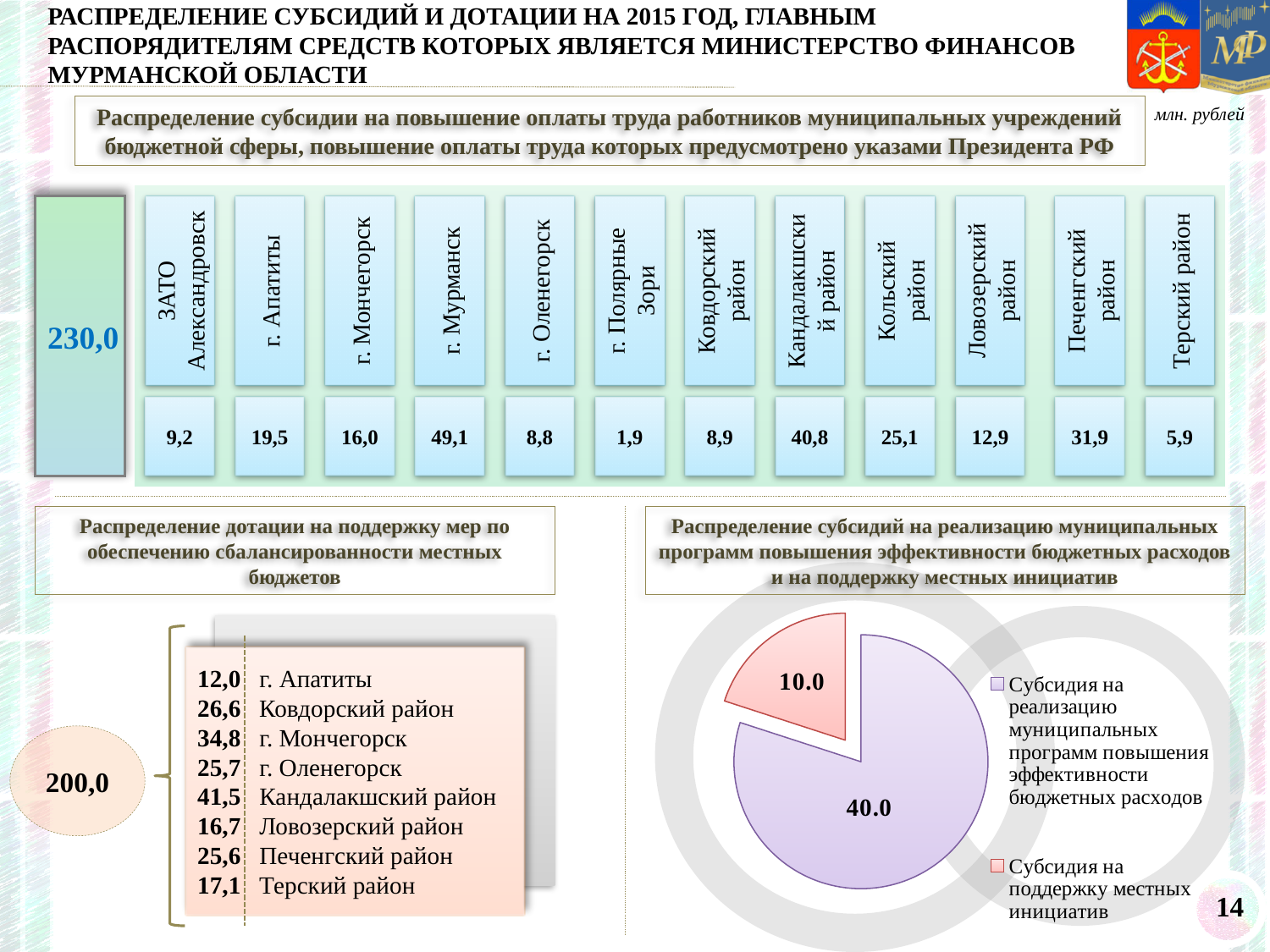
In the pie chart at the bottom right, what is the difference between the two slice values? 30.0 How many entries does the legend of the pie chart at the bottom right list? 2 In the pie chart at the bottom right, what share of the whole pie does the "Субсидия на поддержку местных инициатив" slice represent? 20% In the pie chart at the bottom right, what colour is the slice for "Субсидия на поддержку местных инициатив"? Red (pink) In the pie chart at the bottom right, which slice is the largest? Субсидия на реализацию муниципальных программ повышения эффективности бюджетных расходов In the pie chart at the bottom right, what is the value for "Субсидия на поддержку местных инициатив"? 10.0 In the pie chart at the bottom right, what is the value for "Субсидия на реализацию муниципальных программ повышения эффективности бюджетных расходов"? 40.0 How many slices does the pie chart at the bottom right have? 2 What kind of chart is shown at the bottom right of the slide, under the title "Распределение субсидий на реализацию муниципальных программ повышения эффективности бюджетных расходов и на поддержку местных инициатив"? Pie chart In the pie chart at the bottom right, which slice is the smallest? Субсидия на поддержку местных инициатив In the pie chart at the bottom right, what is the total of the two slice values? 50.0 In the pie chart at the bottom right, which is larger: the slice for "Субсидия на поддержку местных инициатив" or the slice for "Субсидия на реализацию муниципальных программ повышения эффективности бюджетных расходов"? Субсидия на реализацию муниципальных программ повышения эффективности бюджетных расходов